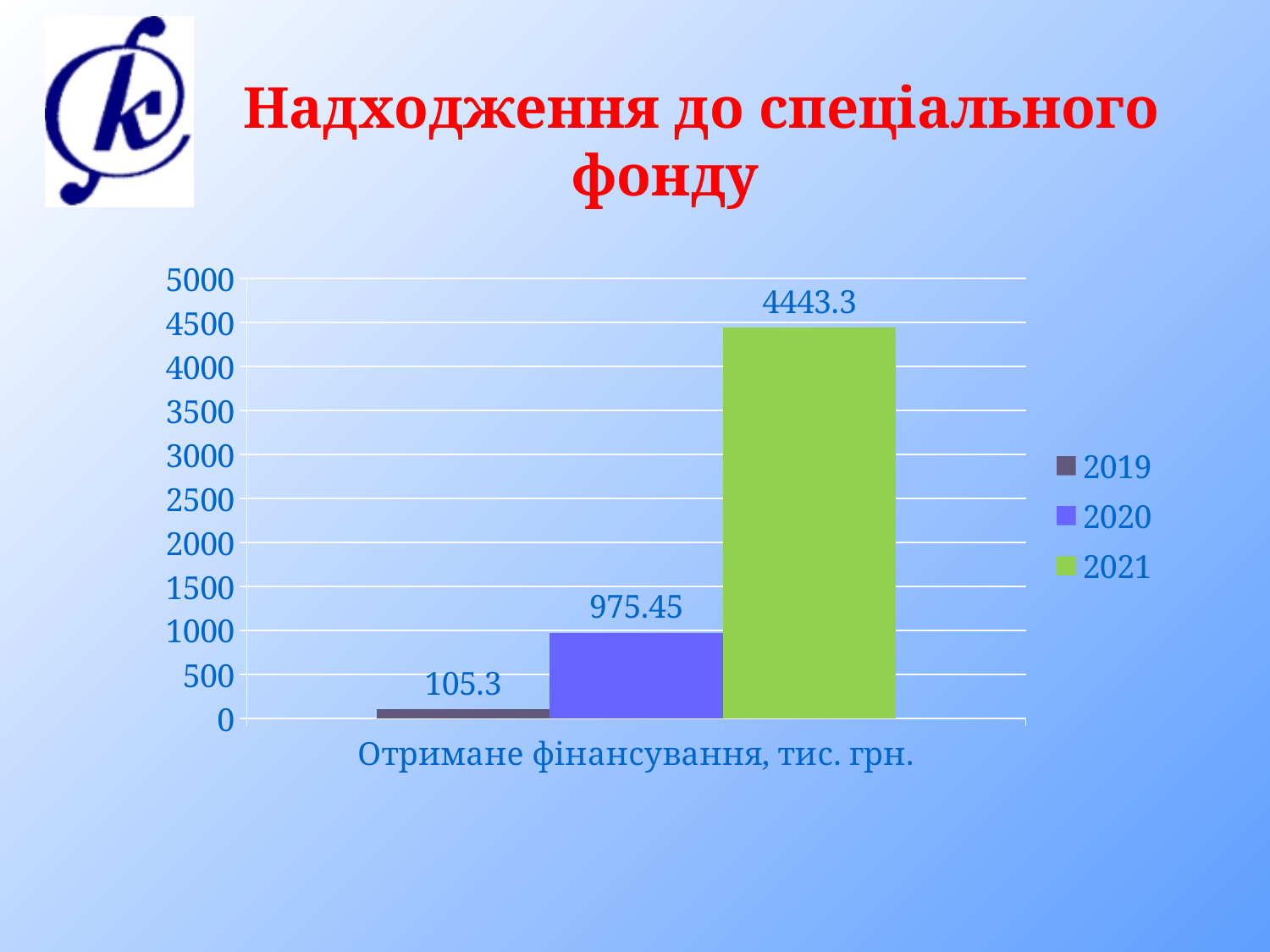
What is the difference between the values for 2021 and 2020? 3467.85 What is the value for 2021 in the chart? 4443.3 Which year has the lowest value in the chart? 2019 Is the value for 2021 greater or less than 4000? greater Which year has the highest value in the chart? 2021 How many series does the legend list? 3 What is the title of the chart on the slide? Надходження до спеціального фонду What is the value for 2019 in the chart? 105.3 What is the difference between the values for 2020 and 2019? 870.15 What kind of chart is shown on the slide? bar chart What is the value for 2020 in the chart? 975.45 Which is larger, the value for 2020 or the value for 2019? 2020